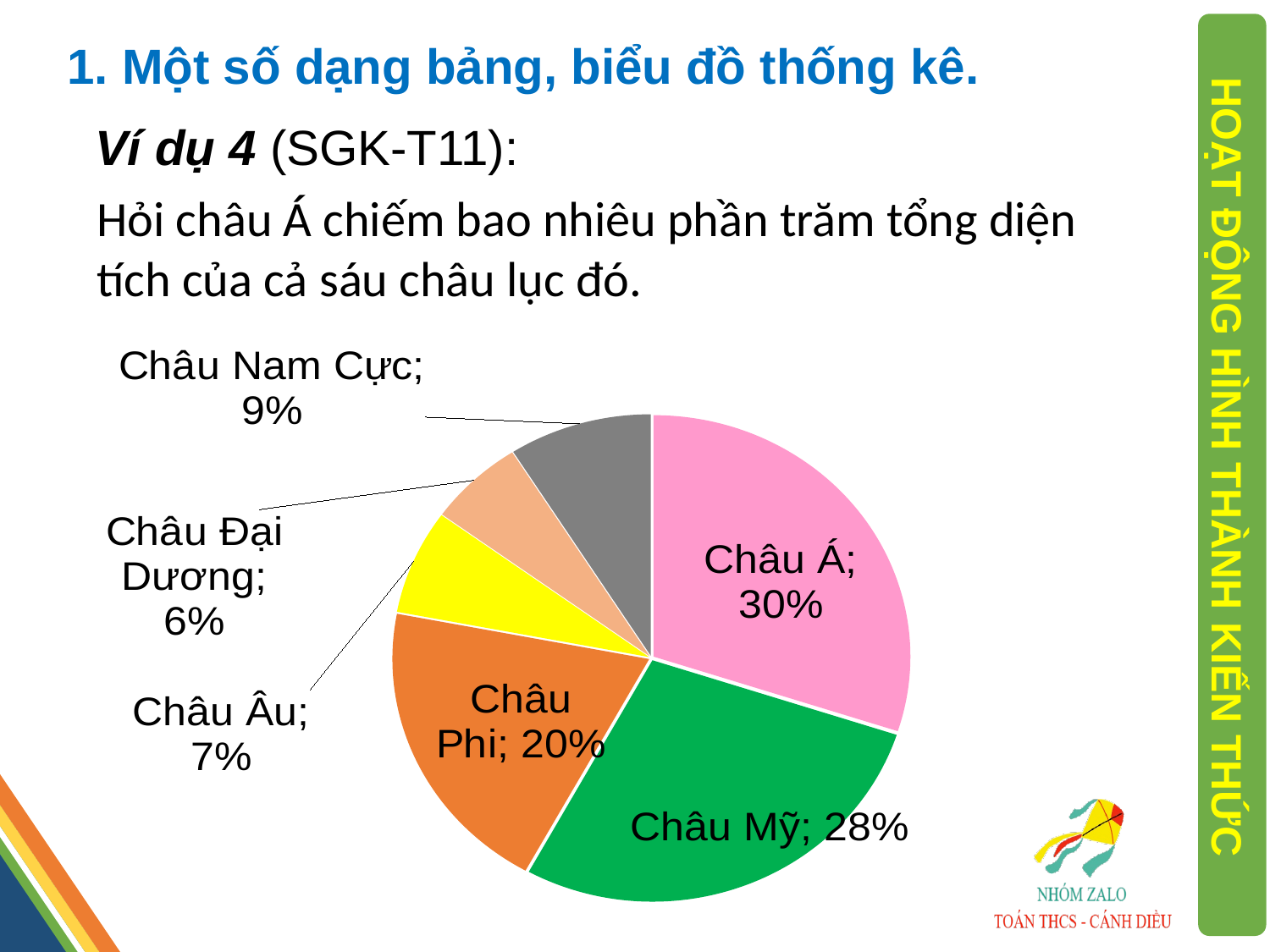
What percentage does Châu Á account for in the pie chart? 30% What percentage does Châu Phi account for in the pie chart? 20% What colour is the slice for Châu Mỹ? green What is the difference in percentage points between Châu Á and Châu Mỹ? 2 What kind of chart is shown on the slide? pie chart Which continent has the smallest slice in the pie chart? Châu Đại Dương Which is larger, the share of Châu Âu or the share of Châu Nam Cực? Châu Nam Cực Which continent has the largest slice in the pie chart? Châu Á What percentage does Châu Nam Cực account for in the pie chart? 9% What percentage does Châu Đại Dương account for in the pie chart? 6% How many slices does the pie chart have? 6 What percentage does Châu Mỹ account for in the pie chart? 28%